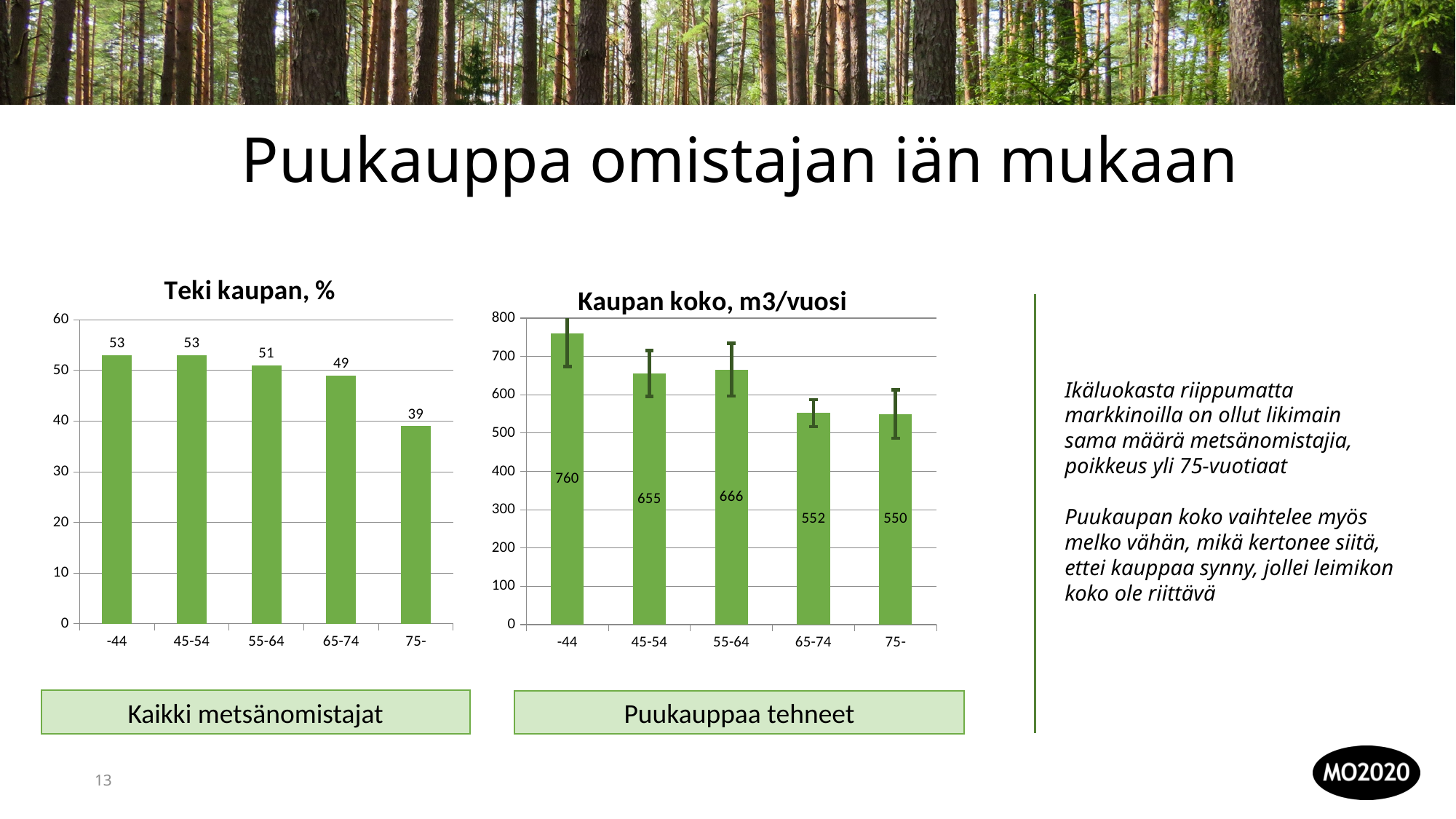
In the 'Kaupan koko, m3/vuosi' chart, what is the difference between the values for -44 and 45-54? 105 In the 'Kaupan koko, m3/vuosi' chart, which age group has the highest value? -44 In the 'Kaupan koko, m3/vuosi' chart, which is larger, the value for 45-54 or the value for 55-64? 55-64 In the 'Teki kaupan, %' chart, what is the difference between the values for 65-74 and 75-? 10 In the 'Teki kaupan, %' chart, what is the value for the 55-64 age group? 51 In the 'Kaupan koko, m3/vuosi' chart, do the values generally rise or fall from the youngest to the oldest age group? Fall In the 'Teki kaupan, %' chart, which age group has the lowest value? 75- In the 'Kaupan koko, m3/vuosi' chart, what is the value for the -44 age group? 760 In the 'Kaupan koko, m3/vuosi' chart, what is the value for the 65-74 age group? 552 In the 'Teki kaupan, %' chart, what is the value for the 75- age group? 39 What kind of chart is the 'Teki kaupan, %' chart? Bar chart In the 'Teki kaupan, %' chart, how many age groups are shown on the x axis? 5